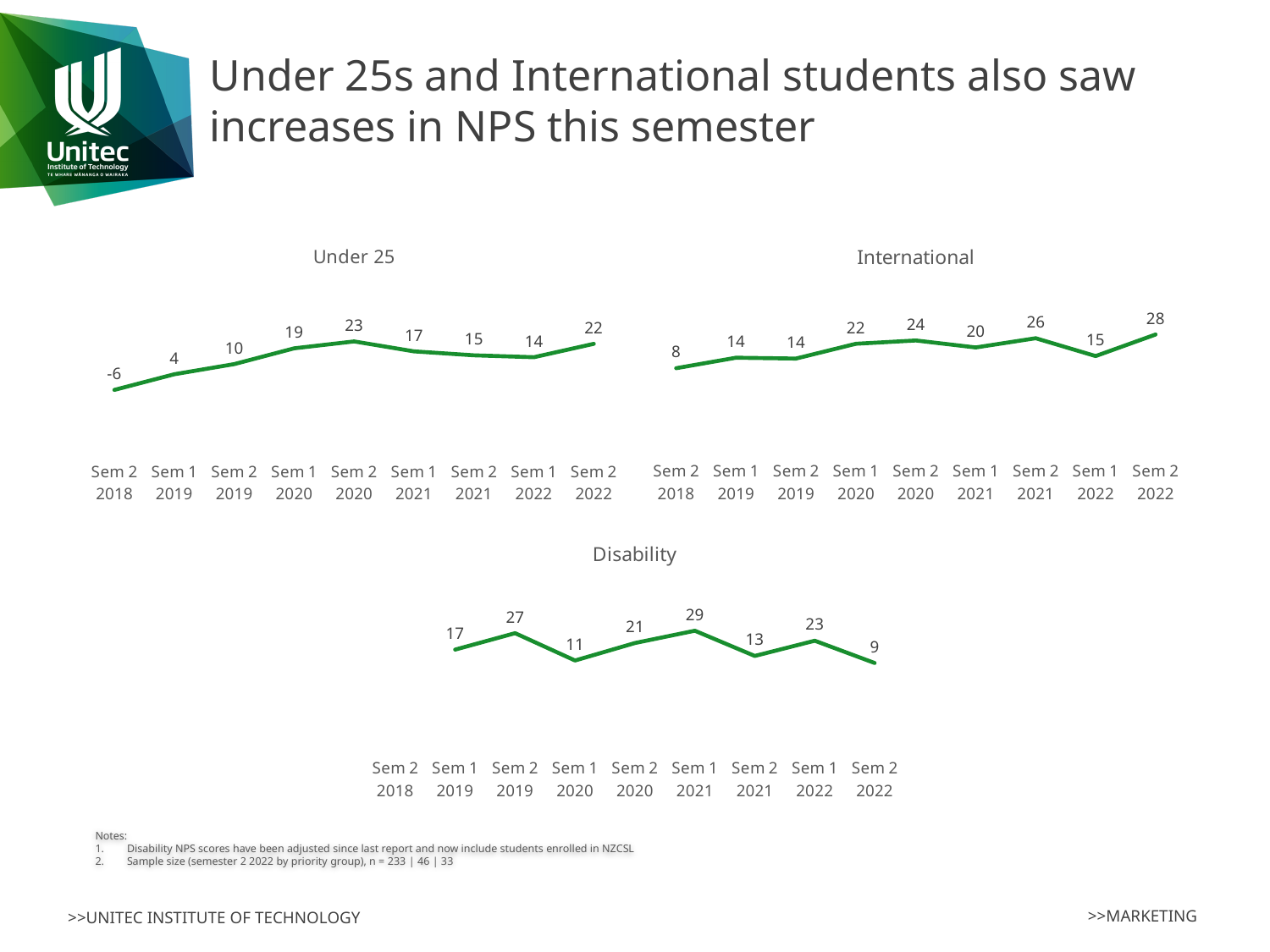
In the Disability chart, which semester has the lowest value? Sem 2 2022 In the Disability chart, what is the difference between the Sem 1 2019 value and the Sem 2 2019 value? 10 In the International chart, which semester has the lowest value? Sem 2 2018 What type of chart is the International chart? line chart In the International chart, is the value for Sem 1 2022 larger or smaller than the value for Sem 2 2021? smaller In the International chart, what is the value for Sem 2 2022? 28 In the International chart, do the values generally rise or fall from Sem 2 2018 to Sem 2 2022? rise In the Under 25 chart, which semester has the highest value? Sem 2 2020 In the Under 25 chart, what is the difference between the Sem 2 2022 value and the Sem 1 2022 value? 8 In the Under 25 chart, what is the NPS value for Sem 2 2018? -6 In the Disability chart, what is the value for Sem 2 2020? 21 How many data points are plotted in the Under 25 chart? 9